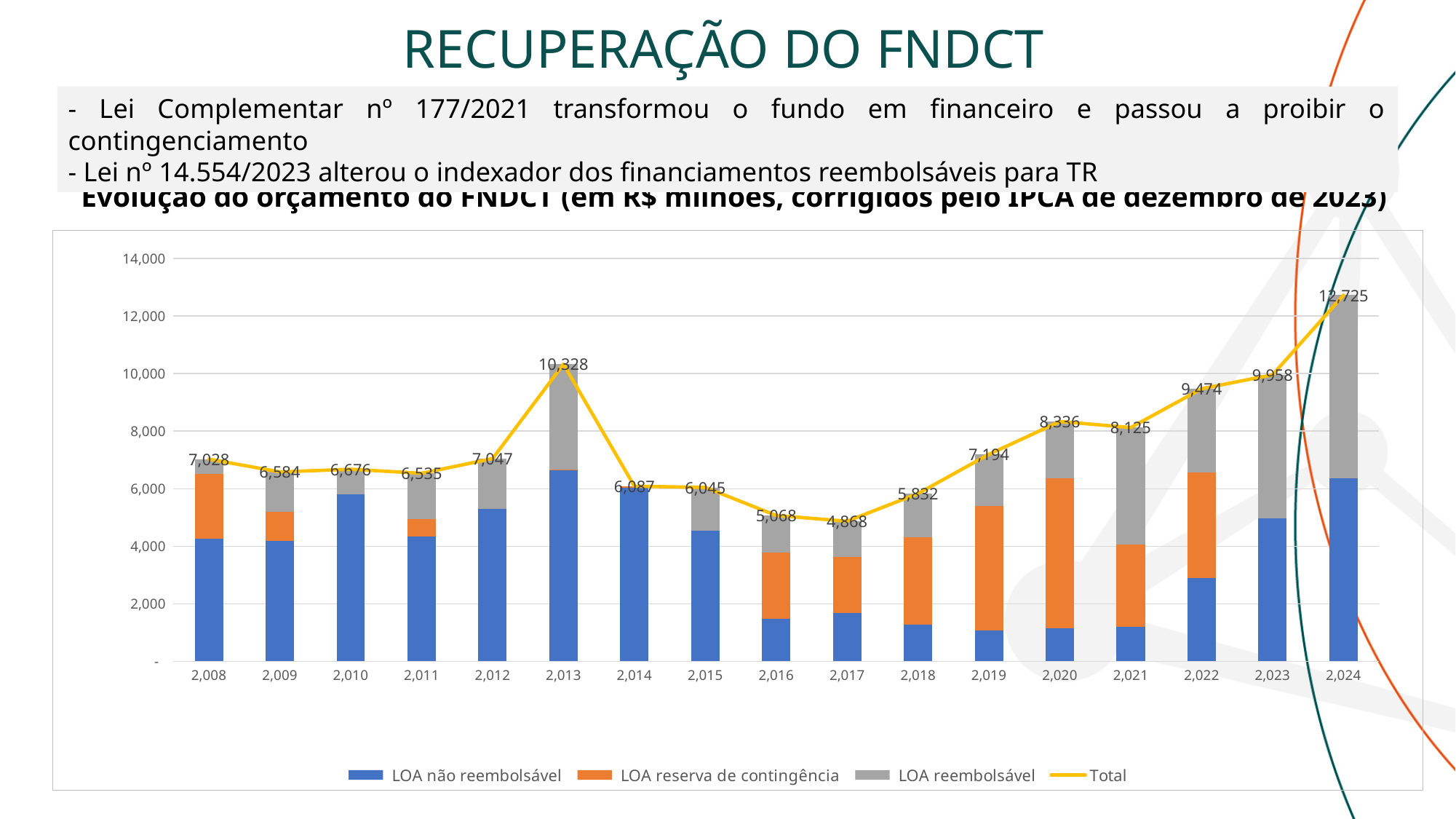
Is the value for LOA não reembolsável in 2,013 greater or less than 6,000? greater What is the Total value for 2,013? 10,328 How many years are shown on the x axis? 17 How many series does the legend list? 4 What is the Total value for 2,017? 4,868 Which year has the highest Total value? 2,024 What is the Total value for 2,024? 12,725 What is the difference between the Total values for 2,013 and 2,012? 3,281 Which year has a larger Total value, 2,020 or 2,021? 2,020 Does the Total value rise or fall from 2,017 to 2,024? rise What is the difference between the Total values for 2,024 and 2,023? 2,767 Which year has the lowest Total value? 2,017